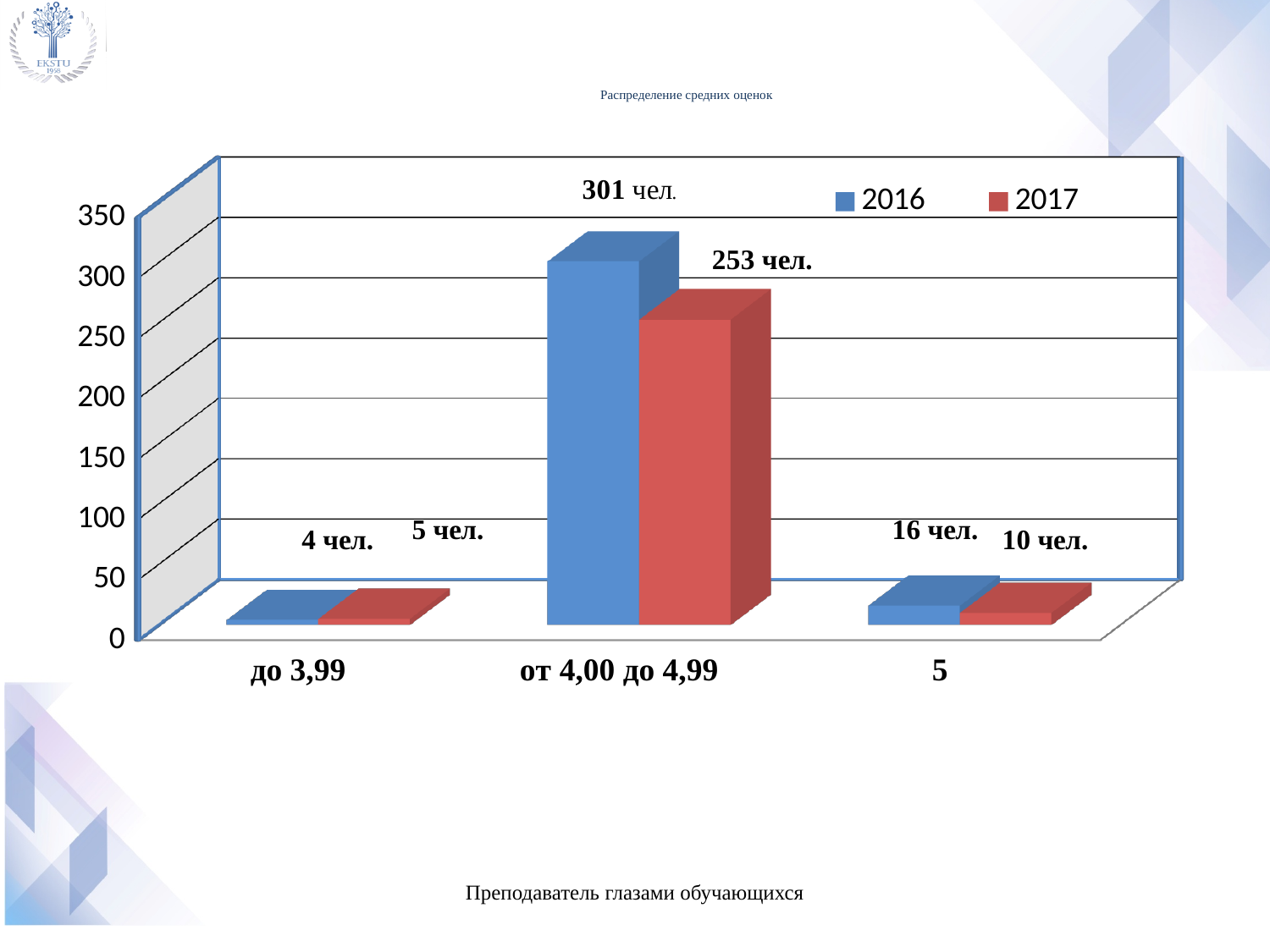
What is the title of the chart? Распределение средних оценок What kind of chart is shown on the slide? Bar chart Which is larger in the category "5": the 2016 value or the 2017 value? 2016 What is the value for 2016 in the category "5"? 16 чел. How many series does the legend list? 2 What is the difference between the 2016 and 2017 values in the category "от 4,00 до 4,99"? 48 чел. How many categories are shown on the x axis? 3 Which category has the highest value for the 2016 series? от 4,00 до 4,99 What is the value for 2016 in the category "от 4,00 до 4,99"? 301 чел. What is the value for 2017 in the category "до 3,99"? 5 чел. Which category has the lowest value for the 2017 series? до 3,99 What is the value for 2017 in the category "от 4,00 до 4,99"? 253 чел.